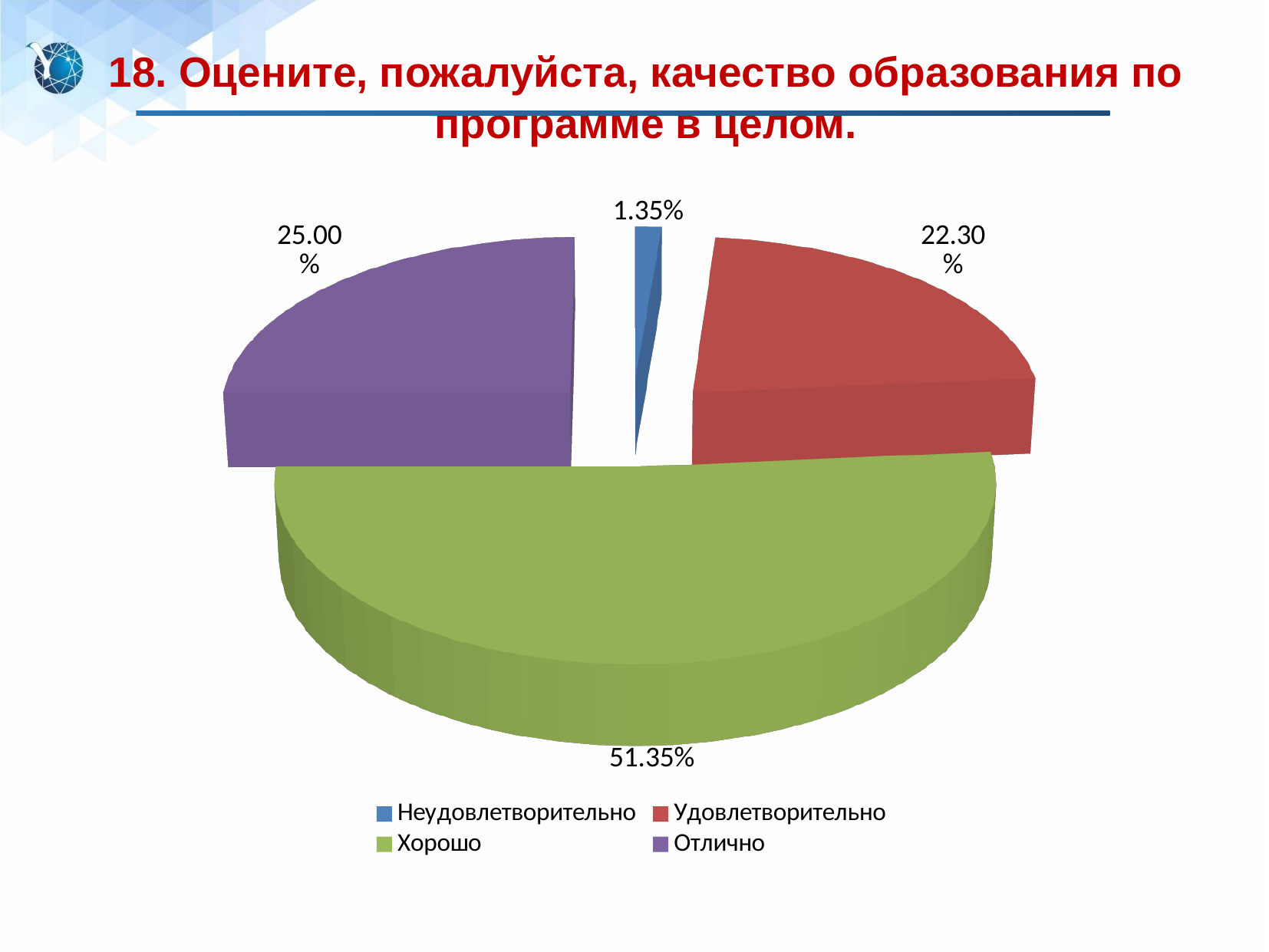
What kind of chart is shown on the slide? pie chart Which category has the largest slice? Хорошо What is the value for Неудовлетворительно? 1.35% What share of the pie does Хорошо have? 51.35% How many categories does the pie chart have? 4 Which is larger, the value for Отлично or the value for Удовлетворительно? Отлично What is the difference between the values for Отлично and Удовлетворительно? 2.70% What colour is the slice for Хорошо? green What is the value for Отлично? 25.00% Which category has the smallest slice? Неудовлетворительно What is the difference between the values for Хорошо and Отлично? 26.35% What is the value for Удовлетворительно? 22.30%